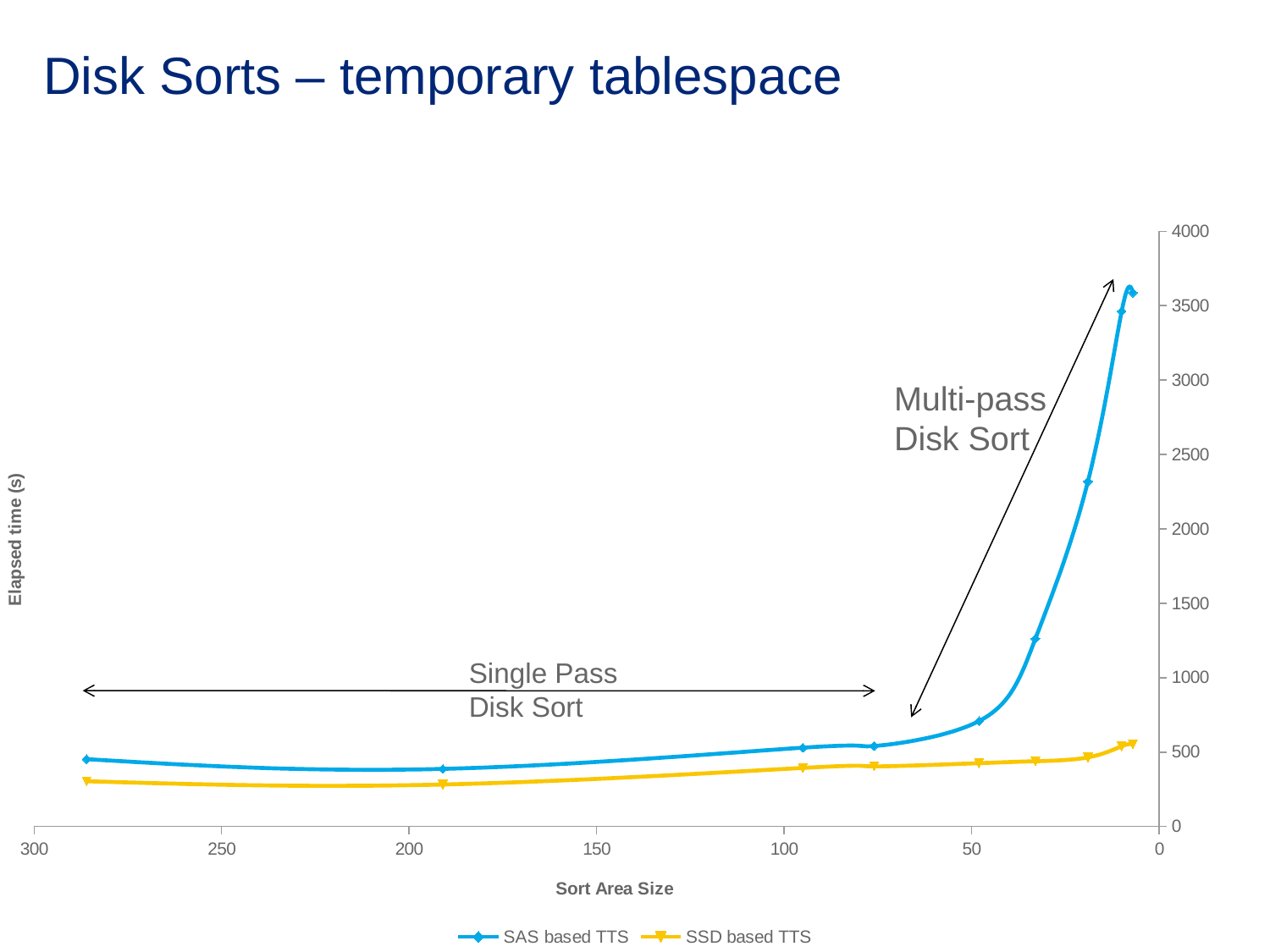
At the smallest sort area sizes on the right of the chart, which series has the larger elapsed time, SAS based TTS or SSD based TTS? SAS based TTS How many series does the legend list? 2 What is the title of the y axis? Elapsed time (s) Is the highest value of the SSD based TTS line greater or less than 1000? less What are the two series named in the legend? SAS based TTS and SSD based TTS Is the value of the SSD based TTS line at the left-hand end of the chart (sort area size near 300) greater or less than 500? less Which series has the lower elapsed time at the right-hand end of the chart (smallest sort area size)? SSD based TTS Is the value of the SAS based TTS line at the left-hand end of the chart (sort area size near 300) greater or less than 1000? less Which series reaches the highest elapsed time on the chart? SAS based TTS Moving from left to right along the x axis, does the SAS based TTS line rise or fall overall? rise What kind of chart is shown on the slide? line chart